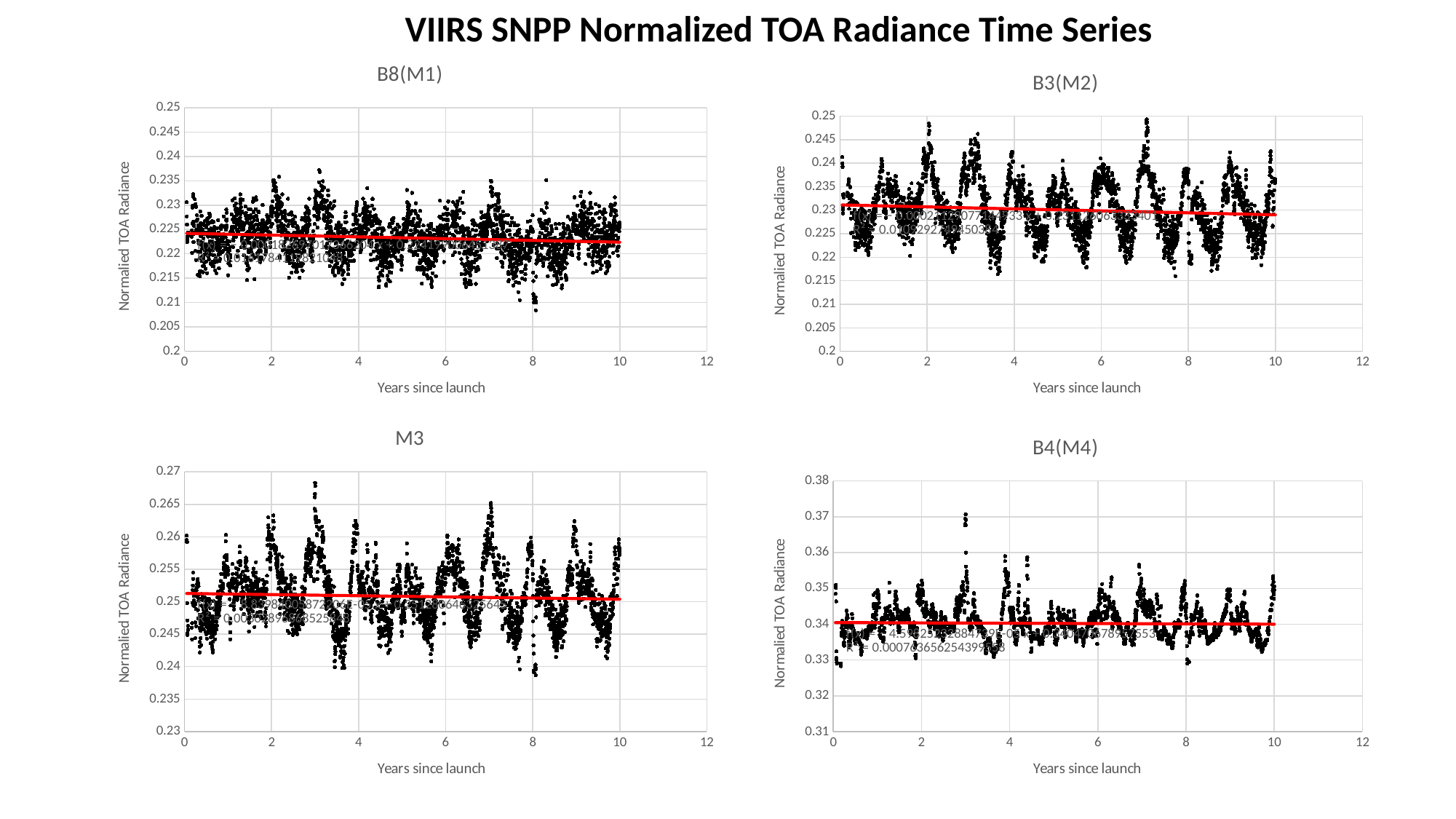
In the B8(M1) chart, is the red trend line greater or less than 0.23? less In the B8(M1) chart, does the red trend line rise or fall as years since launch increase? Fall What is the x-axis label on the M3 chart? Years since launch How many charts are shown on the slide? 4 What kind of chart is the B8(M1) chart? Scatter chart In the B3(M2) chart, does the red trend line rise or fall as years since launch increase? Fall In the B3(M2) chart, is the red trend line greater or less than 0.225? greater In the M3 chart, is the red trend line greater or less than 0.245? greater What is the overall title of the slide's charts? VIIRS SNPP Normalized TOA Radiance Time Series